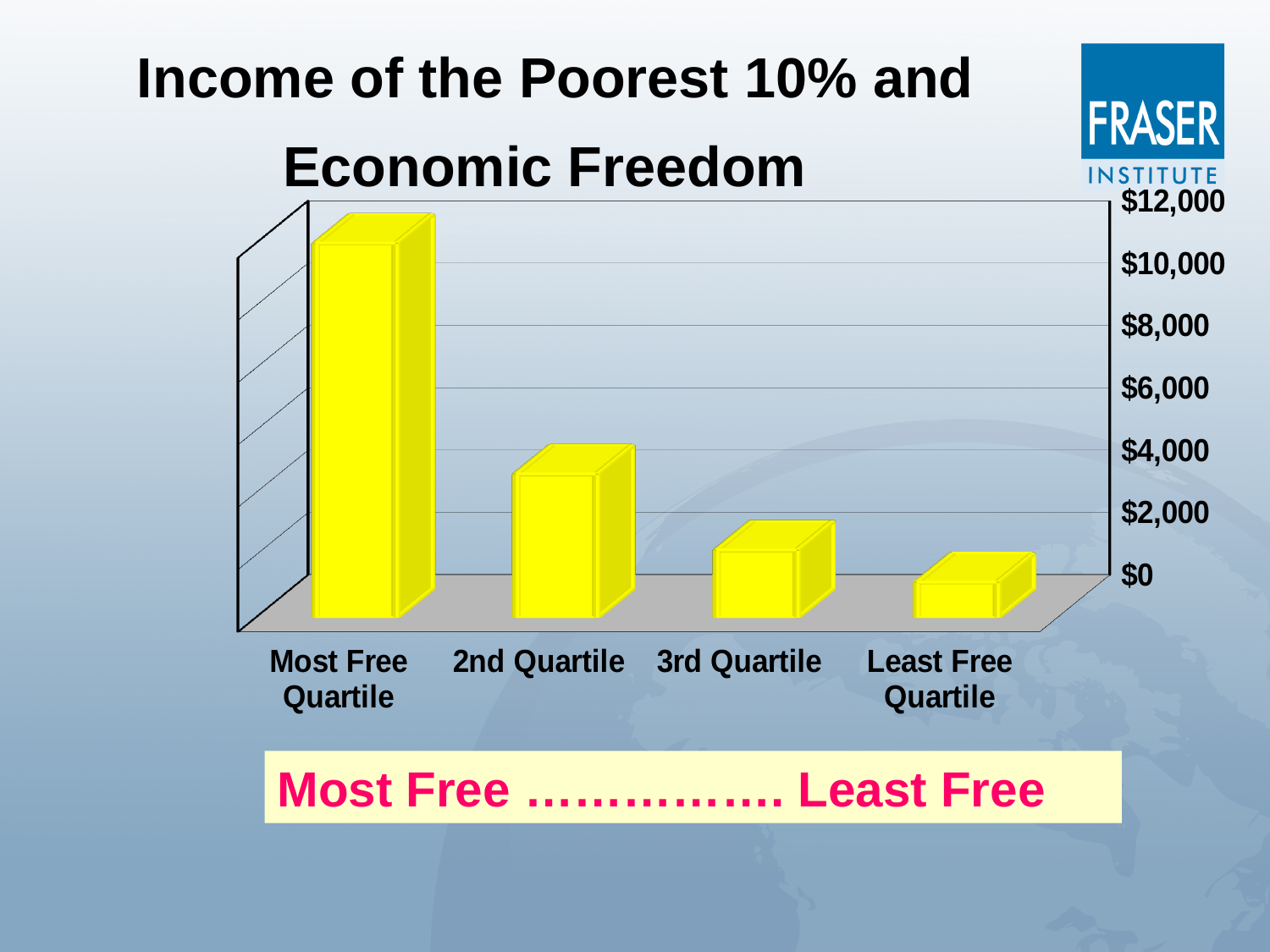
Which category has the highest value? Most Free Quartile How many categories are plotted on the chart? 4 Do the values rise or fall moving from the Most Free Quartile to the Least Free Quartile? fall Which category has the lowest value? Least Free Quartile Is the value for the 2nd Quartile greater or less than $6,000? less Is the value for the Most Free Quartile greater or less than $10,000? greater What kind of chart is shown on the slide? bar chart Which is larger, the value for the 2nd Quartile or the 3rd Quartile? 2nd Quartile What is the title of the chart? Income of the Poorest 10% and Economic Freedom Is the value for the 3rd Quartile greater or less than $4,000? less What colour are the bars in the chart? yellow